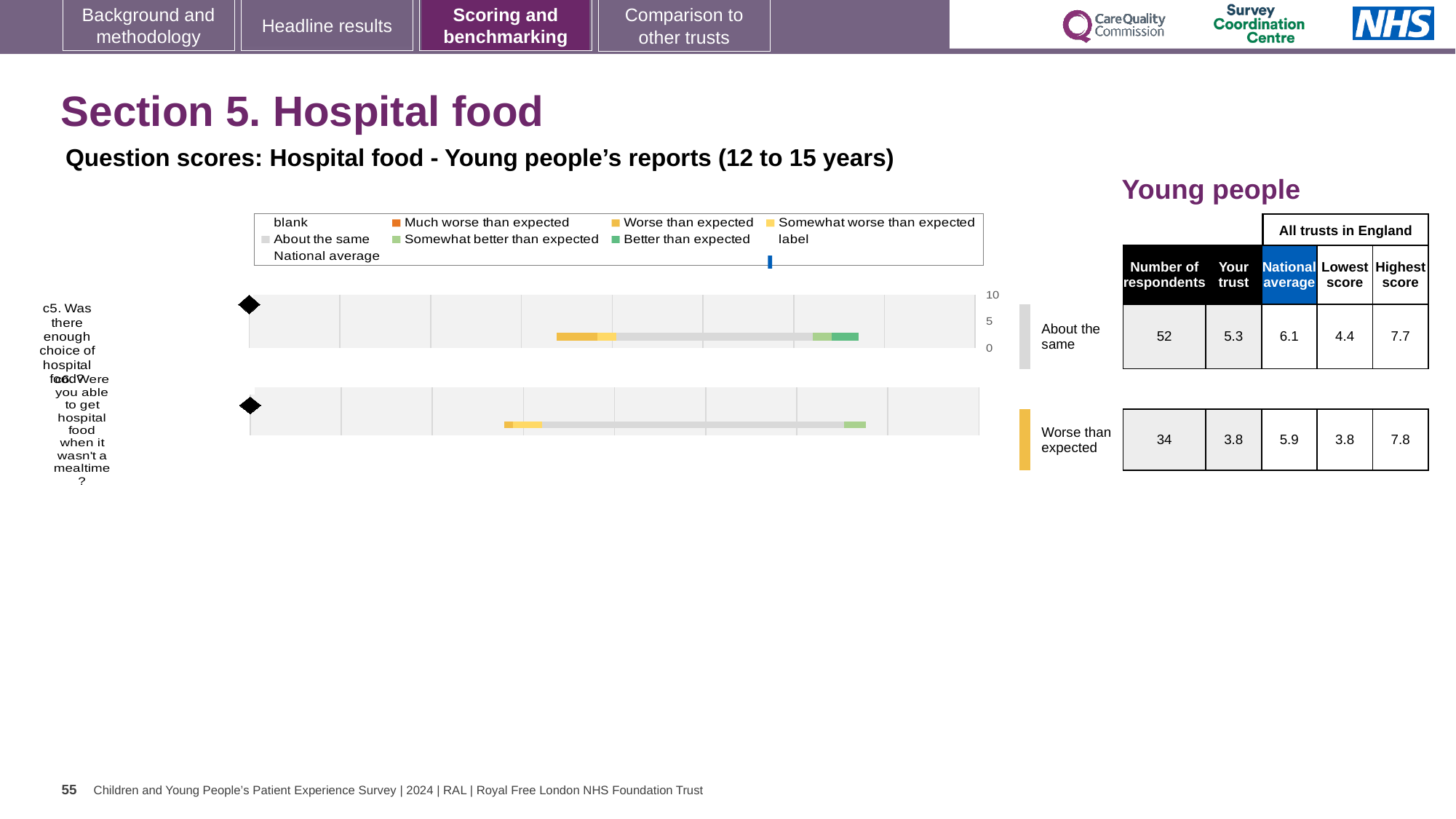
What is the national average score for question c5? 6.1 Which question has the higher 'Your trust' score, c5 or c6? c5 How many respondents answered question c6? 34 What is the 'Your trust' score for question c6 (able to get hospital food when it wasn't a mealtime)? 3.8 What is the 'Your trust' score for question c5 (enough choice of hospital food)? 5.3 What is the highest score among all trusts in England for question c6? 7.8 What is the difference between the national average and the 'Your trust' score for question c5? 0.8 Which benchmark category is shown for question c5 (enough choice of hospital food)? About the same Which benchmark category is shown for question c6 (able to get hospital food when it wasn't a mealtime)? Worse than expected What is the lowest score among all trusts in England for question c5? 4.4 What kind of chart is shown on the slide? Bar chart How many questions (categories) are plotted in the chart? 2